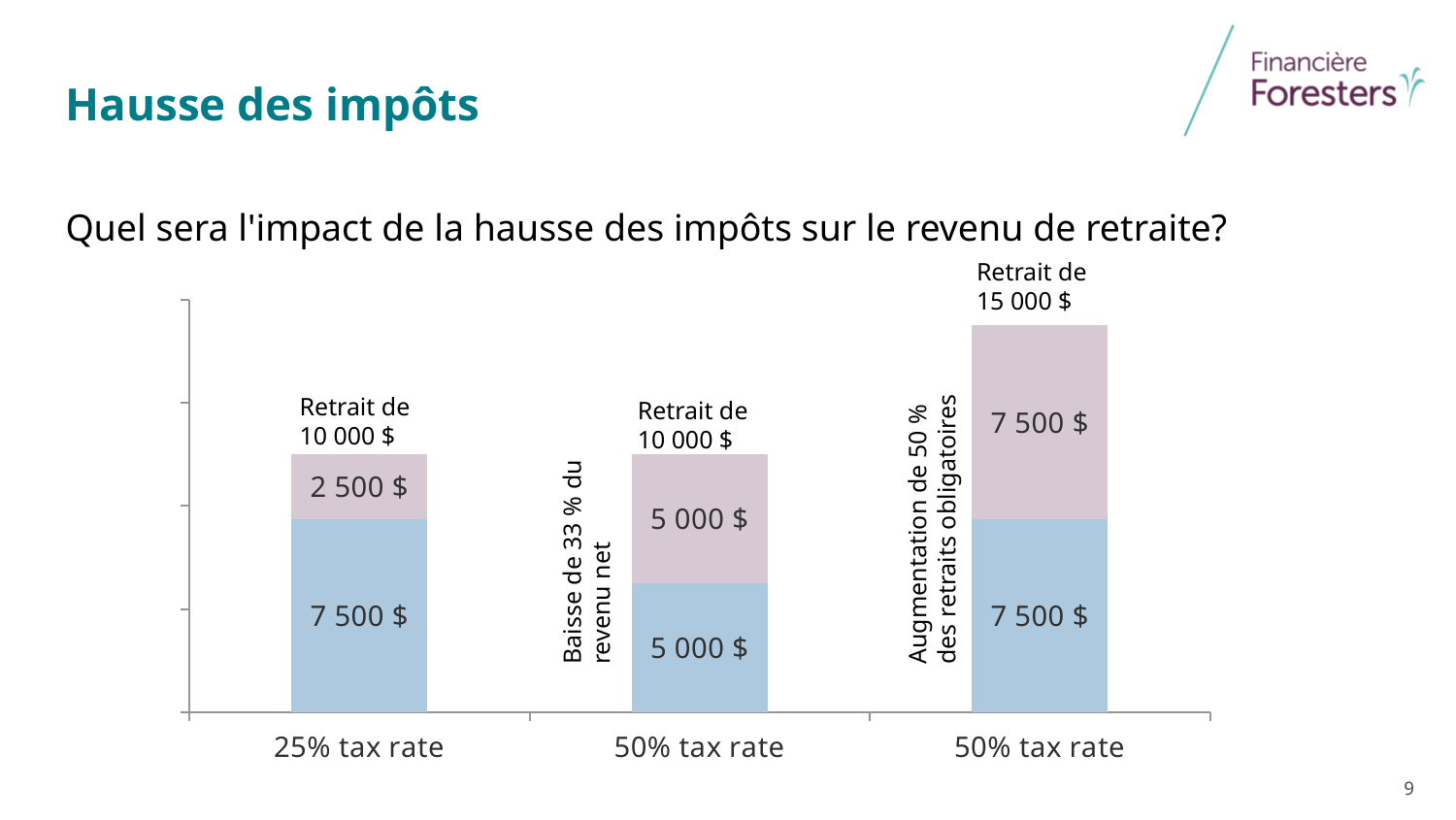
What is the value of the blue (bottom) segment of the middle bar ('50% tax rate')? 5 000 $ What text is written vertically between the middle and rightmost bars? Augmentation de 50 % des retraits obligatoires What is the total withdrawal ('Retrait') shown above the rightmost bar? 15 000 $ What kind of chart is shown on the slide? stacked bar chart Which is larger: the pink segment of the '25% tax rate' bar or the pink segment of the middle '50% tax rate' bar? the pink segment of the middle '50% tax rate' bar Which bar has the highest total? the rightmost bar (50% tax rate) What is the value of the blue (bottom) segment of the bar labelled '25% tax rate'? 7 500 $ What is the value of the pink (top) segment of the bar labelled '25% tax rate'? 2 500 $ What is the difference between the blue segment of the '25% tax rate' bar and the blue segment of the middle '50% tax rate' bar? 2 500 $ What is the total withdrawal ('Retrait') shown above the bar labelled '25% tax rate'? 10 000 $ What is the value of the pink (top) segment of the rightmost bar ('50% tax rate')? 7 500 $ How many bars are plotted in the chart? 3